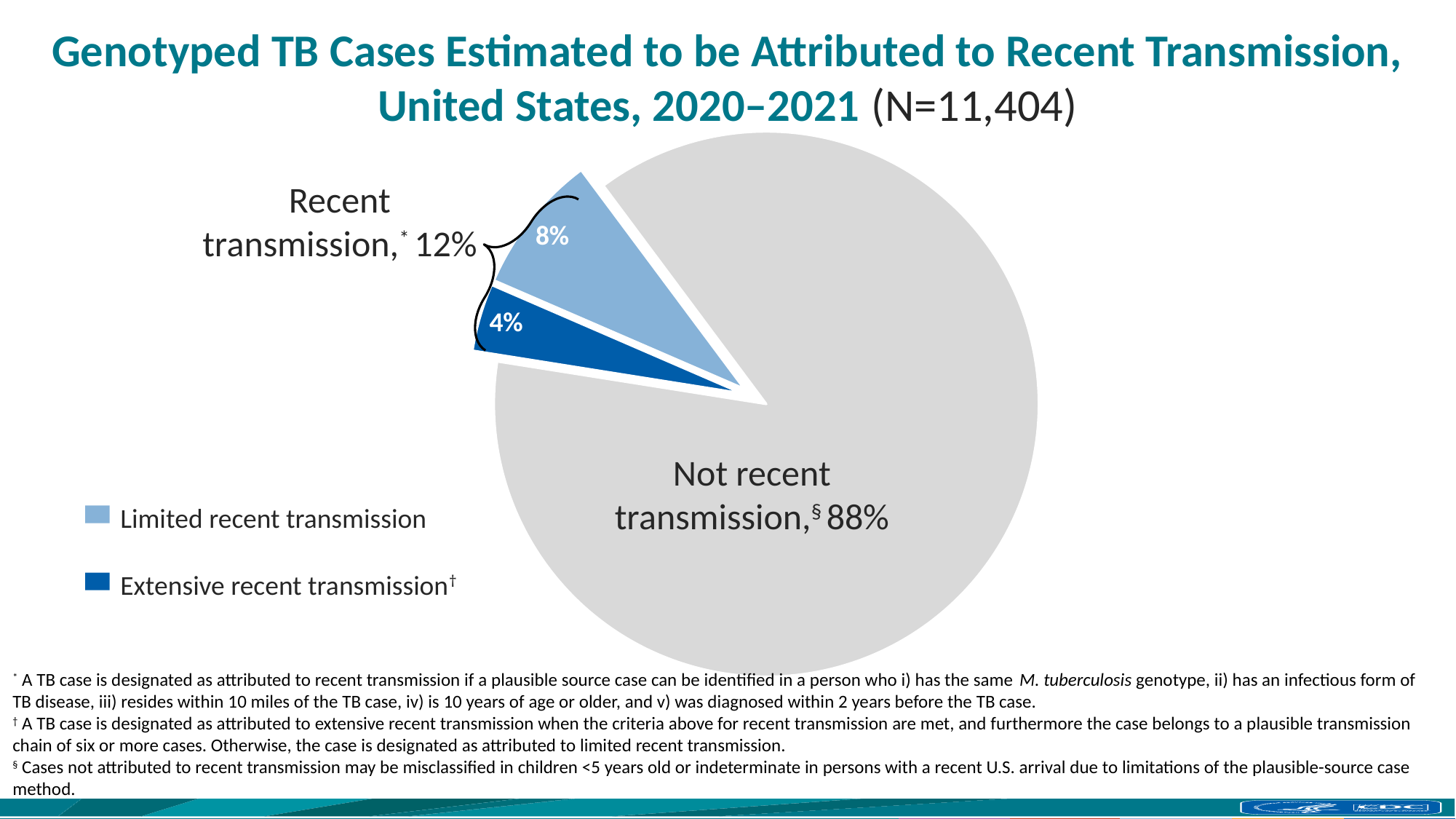
How many entries does the legend list? 2 What is the total number of cases (N) given in the chart title? 11,404 Which slice of the pie is the largest? Not recent transmission What percentage of genotyped TB cases is attributed to not recent transmission? 88% What percentage of genotyped TB cases is attributed to limited recent transmission? 8% Which slice of the pie is the smallest? Extensive recent transmission What kind of chart is shown on the slide? Pie chart Which is larger, the share for limited recent transmission or the share for extensive recent transmission? Limited recent transmission What is the combined share for recent transmission shown on the slide? 12% What percentage of genotyped TB cases is attributed to extensive recent transmission? 4% What is the difference in percentage points between limited recent transmission and extensive recent transmission? 4 How many slices does the pie chart have? 3